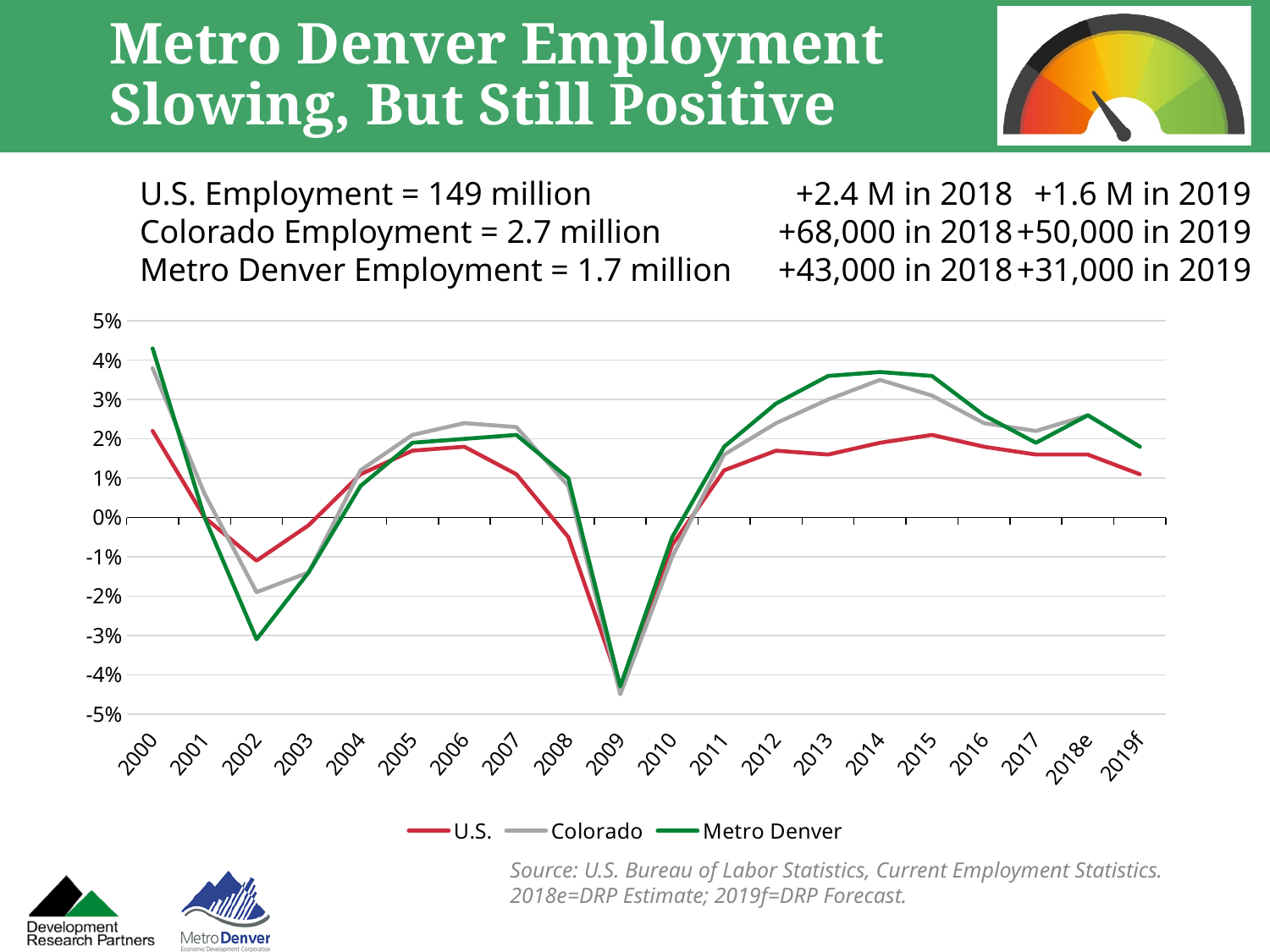
Is the Metro Denver value for 2014 greater or less than 3%? greater Which colour is used for the Metro Denver series in the chart? Green In which year does the Metro Denver line reach its highest value? 2000 In which year does the Metro Denver line reach its lowest value? 2009 How many series does the chart's legend list? 3 Does the Metro Denver line rise or fall from 2015 to 2019f? Fall Is the Metro Denver value for 2009 greater or less than -4%? less Is the U.S. value for 2019f greater or less than 2%? less How many years are plotted along the x axis of the chart? 20 What kind of chart is shown on the slide? Line chart In 2002, which is higher: the U.S. line or the Metro Denver line? U.S.